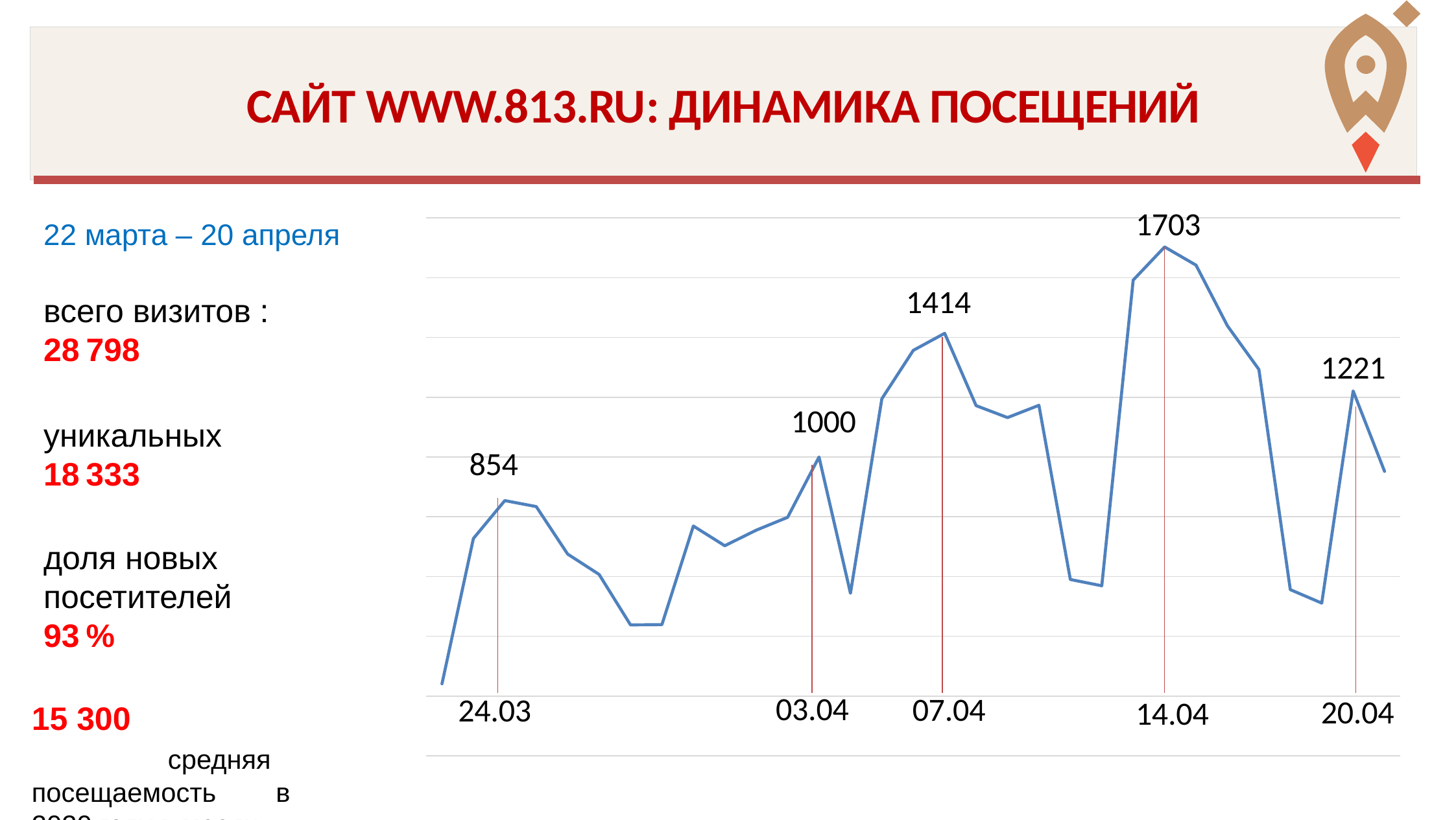
What value is labelled at 14.04 on the chart? 1703 What value is labelled at 20.04 on the chart? 1221 What value is labelled at 24.03 on the chart? 854 How many dates are labelled on the x axis of the chart? 5 What value is labelled at 07.04 on the chart? 1414 What is the difference between the values labelled at 14.04 and 07.04? 289 Which labelled date has the lowest value on the chart? 24.03 Which labelled date has the highest value on the chart? 14.04 Do the labelled values rise or fall from 24.03 to 14.04? rise Which is larger: the value at 20.04 or the value at 03.04? 20.04 What kind of chart is shown on the slide? line chart What value is labelled at 03.04 on the chart? 1000